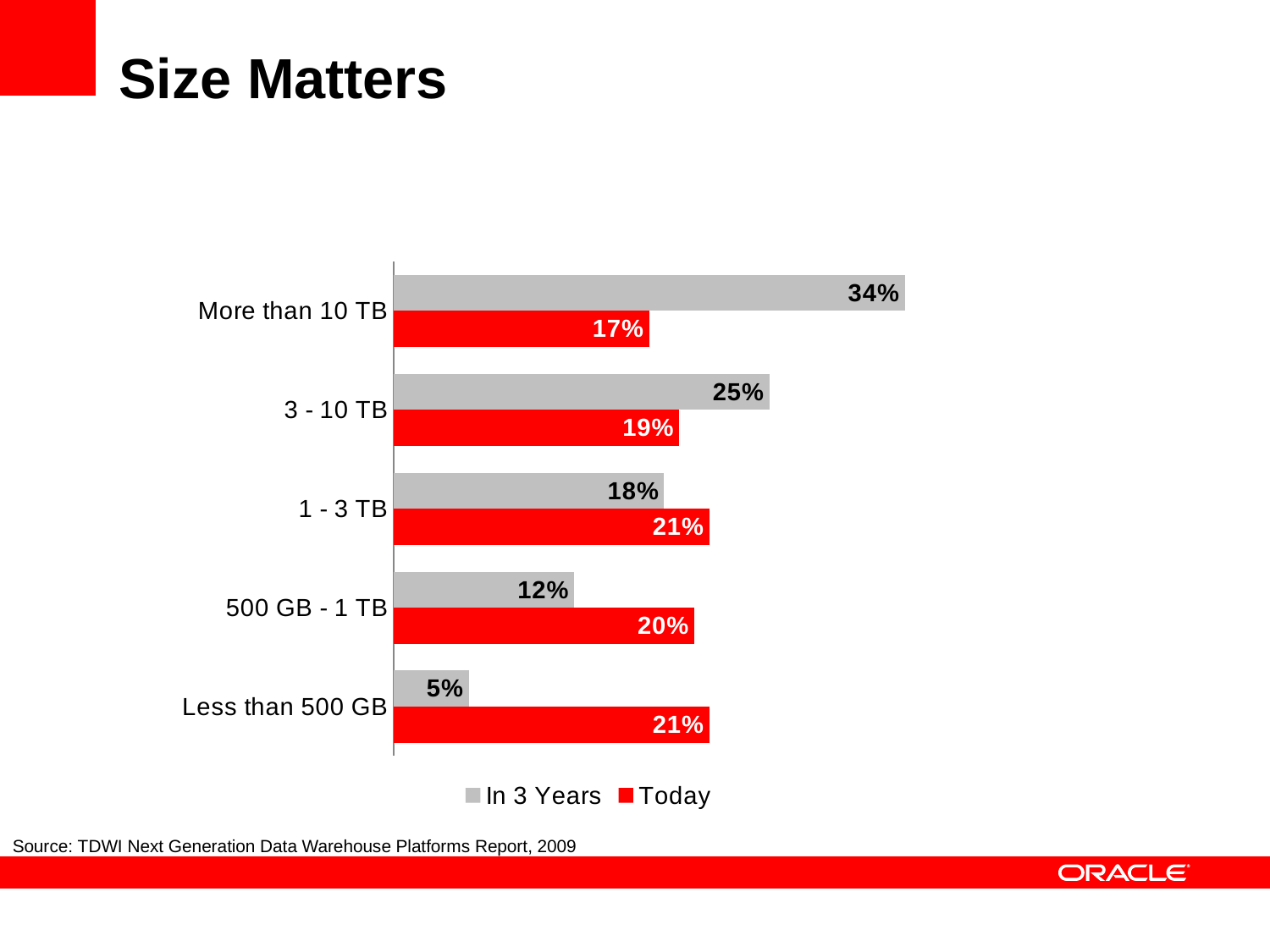
What is the 'Today' value for '500 GB - 1 TB'? 20% For '3 - 10 TB', which is larger: the 'In 3 Years' value or the 'Today' value? In 3 Years What is the difference between the 'In 3 Years' and 'Today' values for 'More than 10 TB'? 17% What is the 'In 3 Years' value for 'Less than 500 GB'? 5% Which category has the highest 'In 3 Years' value? More than 10 TB Which series is shown in red? Today What is the 'In 3 Years' value for 'More than 10 TB'? 34% Which category has the lowest 'Today' value? More than 10 TB What kind of chart is shown on the slide? Bar chart What is the title of the slide containing the chart? Size Matters How many series does the legend list? 2 How many size categories are shown on the chart? 5